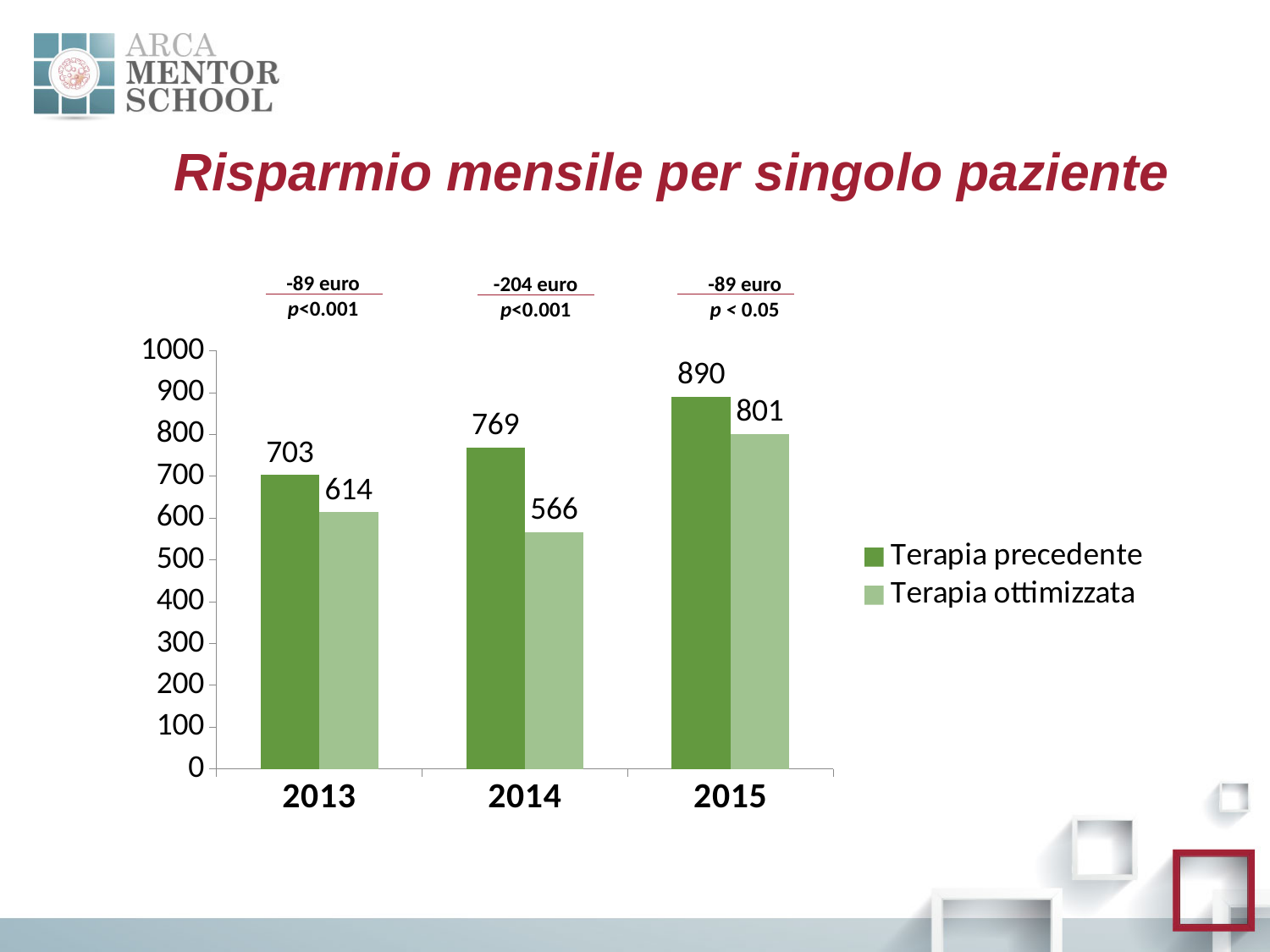
How many years are shown on the x axis? 3 Does the Terapia precedente value rise or fall from 2013 to 2015? Rise In which year is the Terapia ottimizzata value lowest? 2014 What is the value for Terapia ottimizzata in 2015? 801 How many series does the legend list? 2 Is the value for Terapia precedente in 2015 greater or less than 800? greater In which year is the Terapia precedente value highest? 2015 What is the value for Terapia precedente in 2014? 769 What kind of chart is shown on the slide? Bar chart Which is larger in 2013: Terapia precedente or Terapia ottimizzata? Terapia precedente What is the value for Terapia ottimizzata in 2013? 614 What is the difference between Terapia precedente and Terapia ottimizzata in 2014? 203